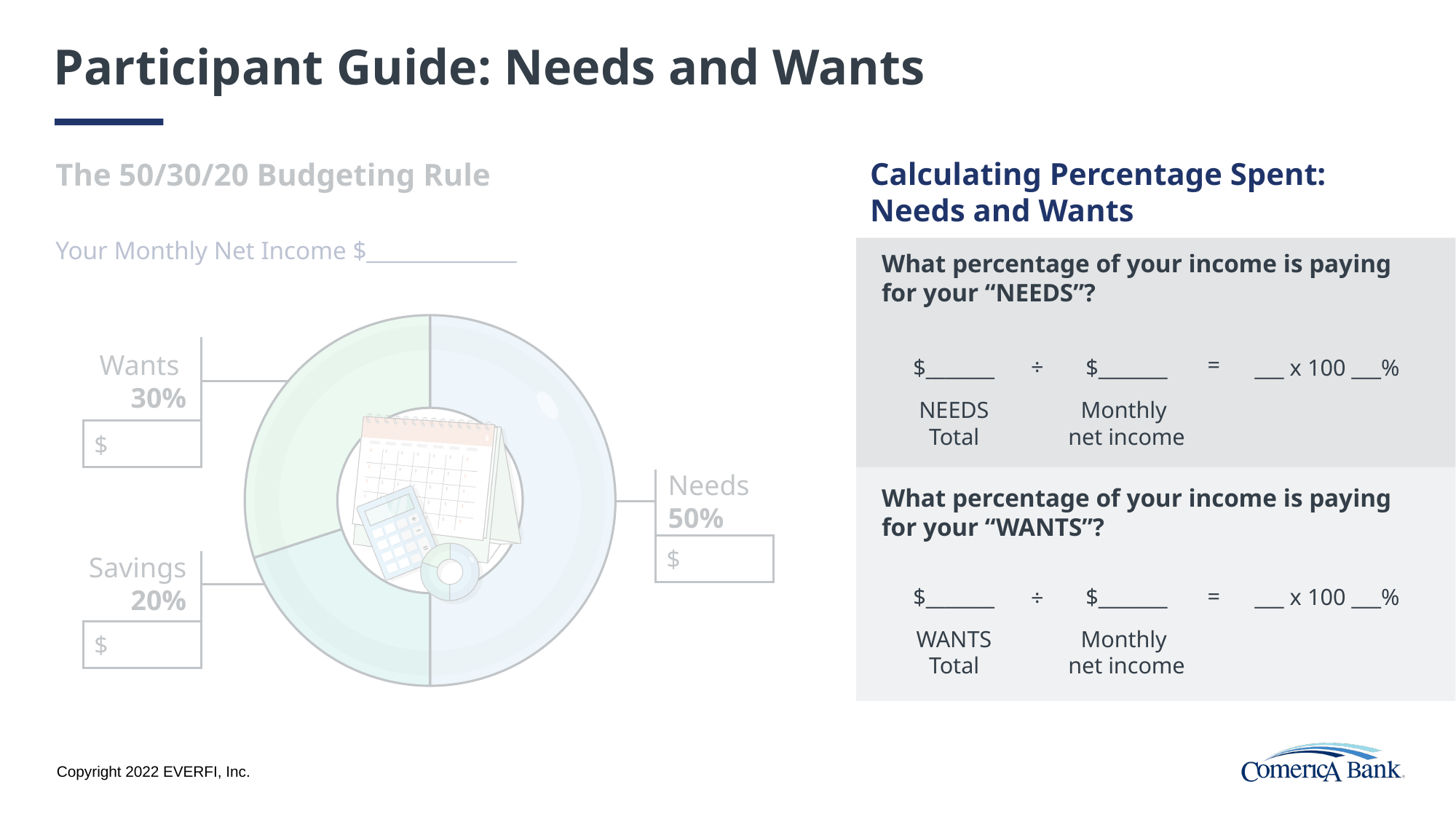
What percentage of income does the 50/30/20 chart allocate to Wants? 30% What is the difference in percentage points between Wants and Savings in the 50/30/20 chart? 10 In the 50/30/20 chart, which is larger: Wants or Savings? Wants Which category has the smallest share in the 50/30/20 chart? Savings Which category has the largest share in the 50/30/20 chart? Needs What percentage of income does the 50/30/20 chart allocate to Savings? 20% What kind of chart is used to show the 50/30/20 Budgeting Rule? Pie chart (donut) How many categories are shown in the 50/30/20 chart? 3 What is the combined share of Wants and Savings in the 50/30/20 chart? 50% What is the title of the chart on the left of the slide? The 50/30/20 Budgeting Rule What is the difference in percentage points between Needs and Wants in the 50/30/20 chart? 20 What percentage of income does the 50/30/20 chart allocate to Needs? 50%